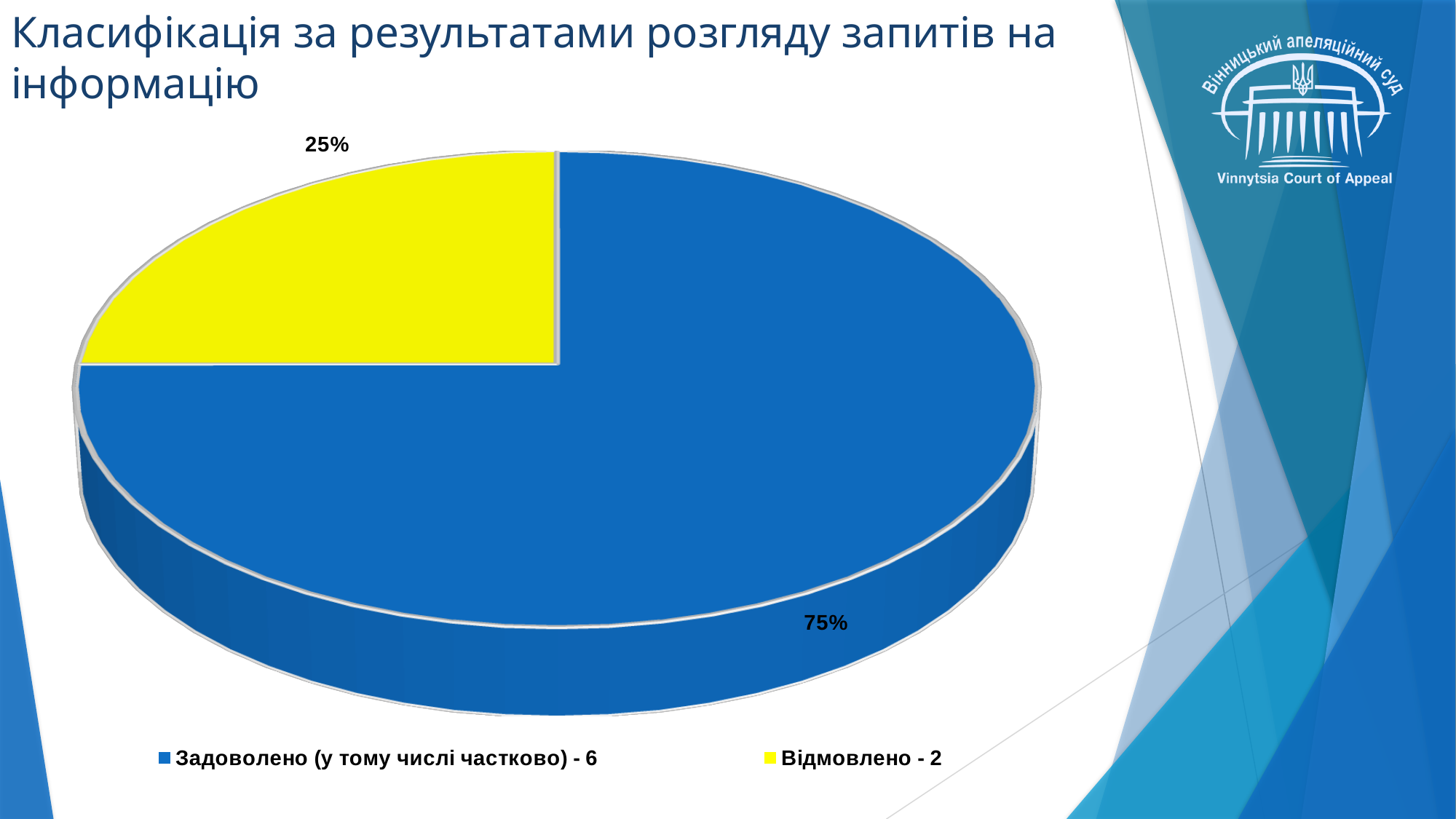
Which category has the largest slice of the pie? Задоволено (у тому числі частково) - 6 What is the difference in percentage points between the 75% slice and the 25% slice? 50 What colour is the slice for "Відмовлено - 2"? yellow Which category has the smallest slice of the pie? Відмовлено - 2 How many entries does the legend list? 2 What is the title of the slide containing the chart? Класифікація за результатами розгляду запитів на інформацію What kind of chart is shown on the slide? pie chart Is the share for "Задоволено (у тому числі частково) - 6" greater or less than 50%? greater How many slices does the pie chart have? 2 What percentage share does the slice for "Задоволено (у тому числі частково) - 6" have? 75% What percentage share does the slice for "Відмовлено - 2" have? 25% Which slice is larger: "Задоволено (у тому числі частково) - 6" or "Відмовлено - 2"? Задоволено (у тому числі частково) - 6